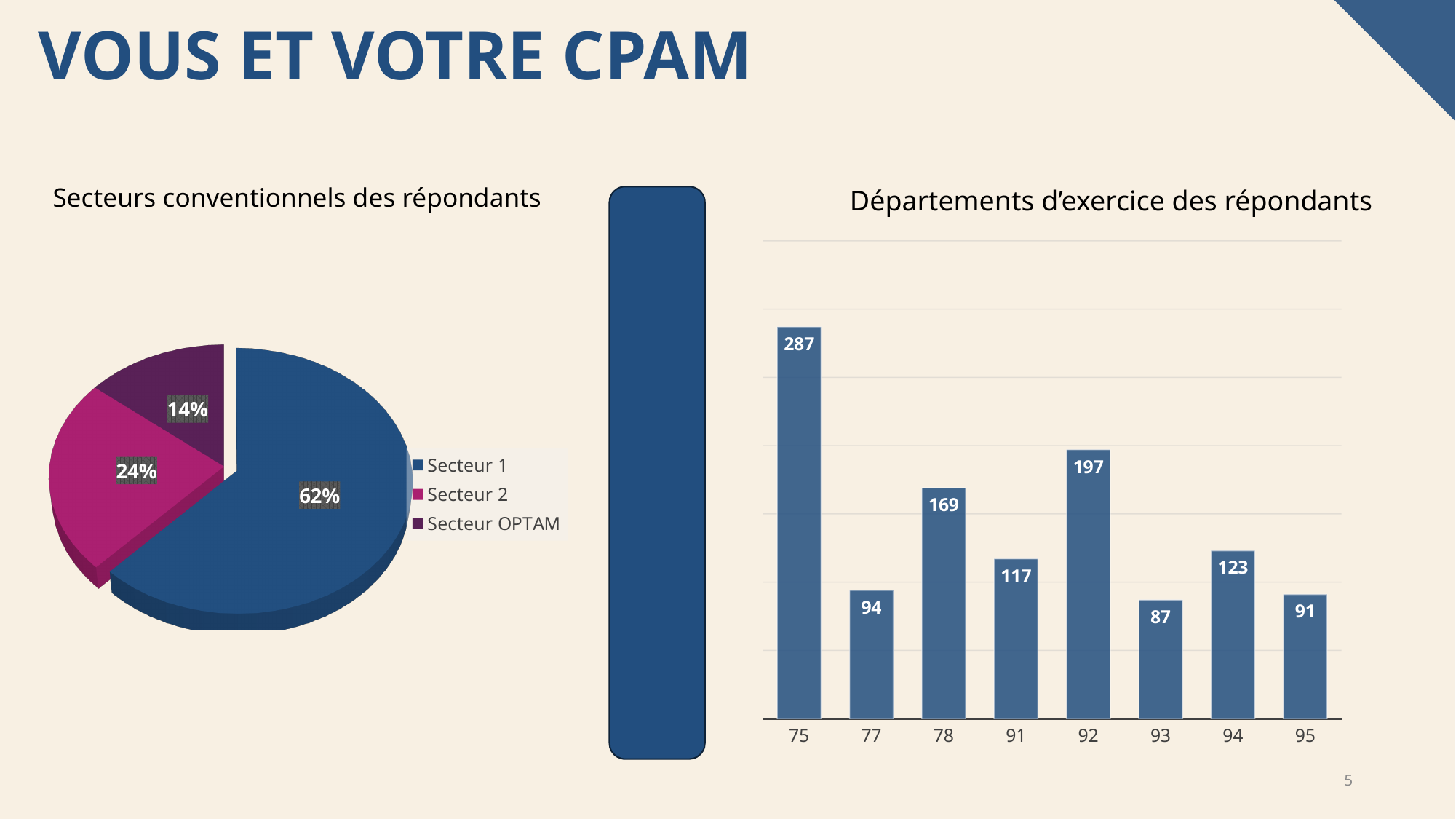
How many departments are shown in the 'Départements d'exercice des répondants' bar chart? 8 In the 'Départements d'exercice des répondants' chart, which department has the highest value? 75 In the 'Départements d'exercice des répondants' chart, what is the difference between the values for departments 75 and 78? 118 What kind of chart is 'Secteurs conventionnels des répondants'? Pie chart In the 'Secteurs conventionnels des répondants' pie chart, what share does Secteur 1 have? 62% In the 'Secteurs conventionnels des répondants' pie chart, how many categories does the legend list? 3 In the 'Départements d'exercice des répondants' chart, which has a larger value, department 94 or department 91? 94 In the 'Secteurs conventionnels des répondants' pie chart, what share does Secteur OPTAM have? 14% In the 'Départements d'exercice des répondants' chart, what is the value for department 92? 197 In the 'Secteurs conventionnels des répondants' pie chart, which sector has the smallest share? Secteur OPTAM In the 'Départements d'exercice des répondants' chart, which department has the lowest value? 93 In the 'Départements d'exercice des répondants' chart, what is the value for department 93? 87